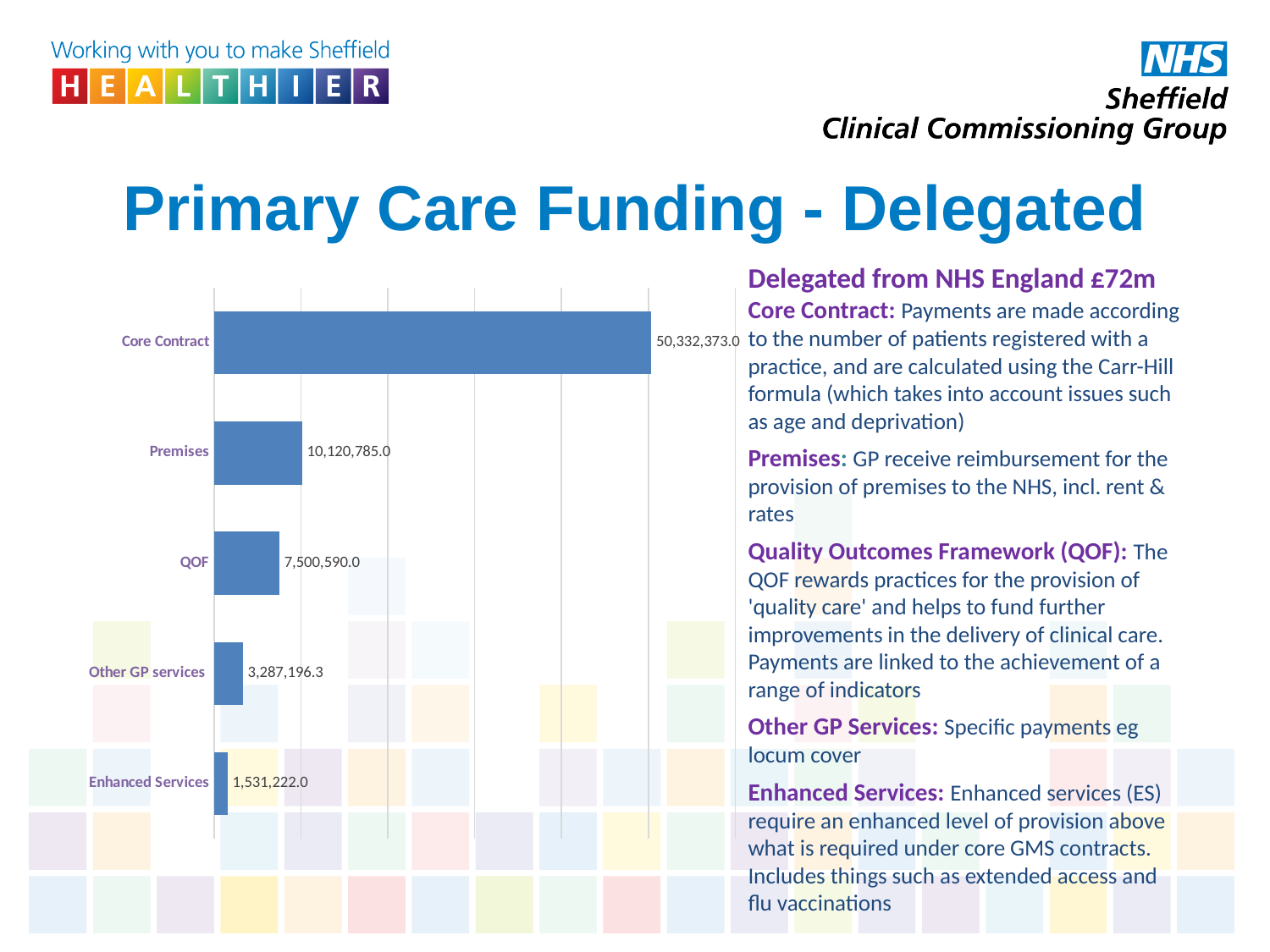
Which is larger, the value for QOF or the value for Other GP services? QOF What is the value for QOF? 7,500,590.0 What is the value for Enhanced Services? 1,531,222.0 What is the value for Core Contract? 50,332,373.0 What is the value for Premises? 10,120,785.0 What is the difference between the values for Other GP services and Enhanced Services? 1,755,974.3 What kind of chart is shown on the slide? Bar chart What is the difference between the values for Premises and QOF? 2,620,195.0 What is the value for Other GP services? 3,287,196.3 Which category has the highest value? Core Contract How many categories are shown in the chart? 5 Which category has the lowest value? Enhanced Services